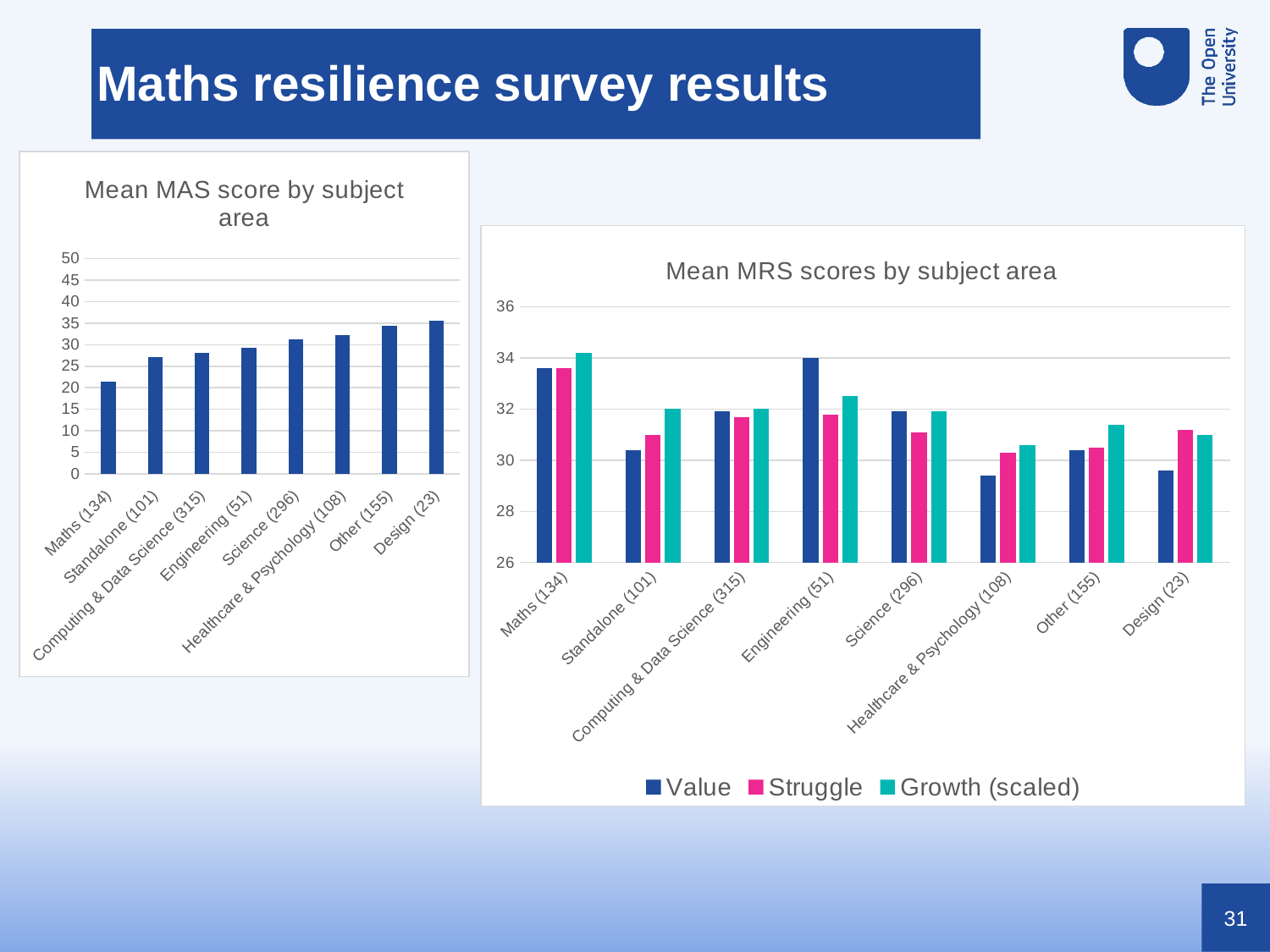
What are the three series listed in the legend of the "Mean MRS scores by subject area" chart? Value, Struggle, Growth (scaled) In the "Mean MAS score by subject area" chart, which subject area has the lowest mean MAS score? Maths (134) In the "Mean MAS score by subject area" chart, is the value for Other (155) greater or less than 30? greater How many subject areas are shown in the "Mean MAS score by subject area" chart? 8 In the "Mean MAS score by subject area" chart, is the value for Maths (134) greater or less than 25? less In the "Mean MAS score by subject area" chart, which subject area has the highest mean MAS score? Design (23) In the "Mean MRS scores by subject area" chart, is the Value score for Engineering (51) greater or less than the Struggle score for Engineering (51)? greater In the "Mean MRS scores by subject area" chart, which subject area has the lowest Value score? Healthcare & Psychology (108) What kind of chart is the "Mean MAS score by subject area" chart? bar chart How many series does the legend of the "Mean MRS scores by subject area" chart list? 3 In the "Mean MRS scores by subject area" chart, which subject area has the highest Value score? Engineering (51) In the "Mean MAS score by subject area" chart, do the values rise or fall from left to right along the x axis? rise